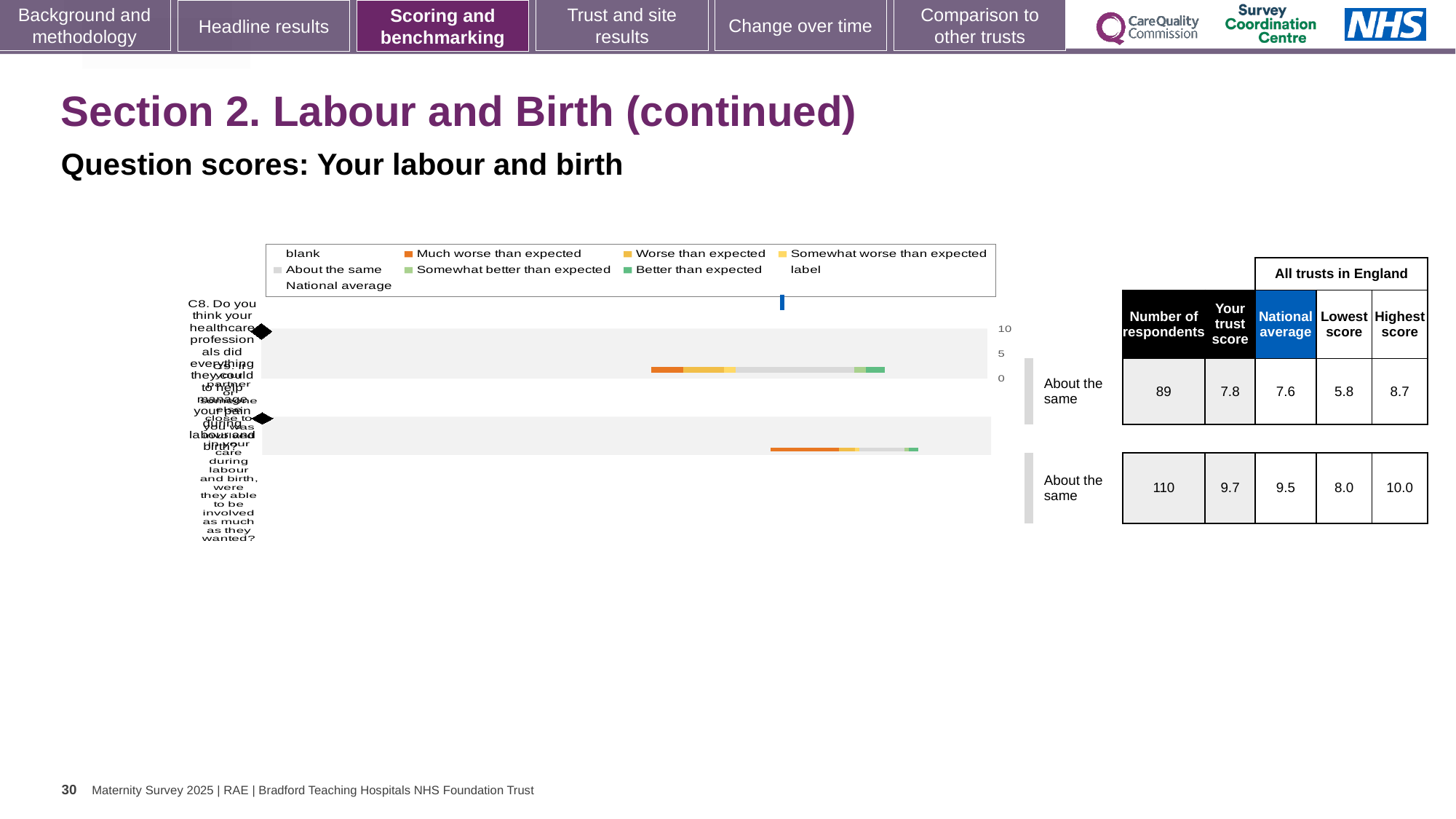
What benchmark category is shown for both rows next to the chart? About the same Does the chart legend include an entry for 'National average'? Yes According to the table beside the chart, what is the trust score for the second row? 9.7 How many respondents are listed for the first row (question C8)? 89 According to the table beside the chart, what is the trust score for the first row (question C8)? 7.8 What is the highest score across all trusts in England for the second row? 10.0 In the chart legend, what colour represents 'Much worse than expected'? orange What kind of chart is shown on the slide? bar chart What is the difference between the trust scores of the second row (9.7) and the first row (7.8)? 1.9 How many question rows (bars) does the chart show? 2 What is the national average for the second row in the table? 9.5 Which row has the higher trust score in the table, the first (C8) or the second? the second